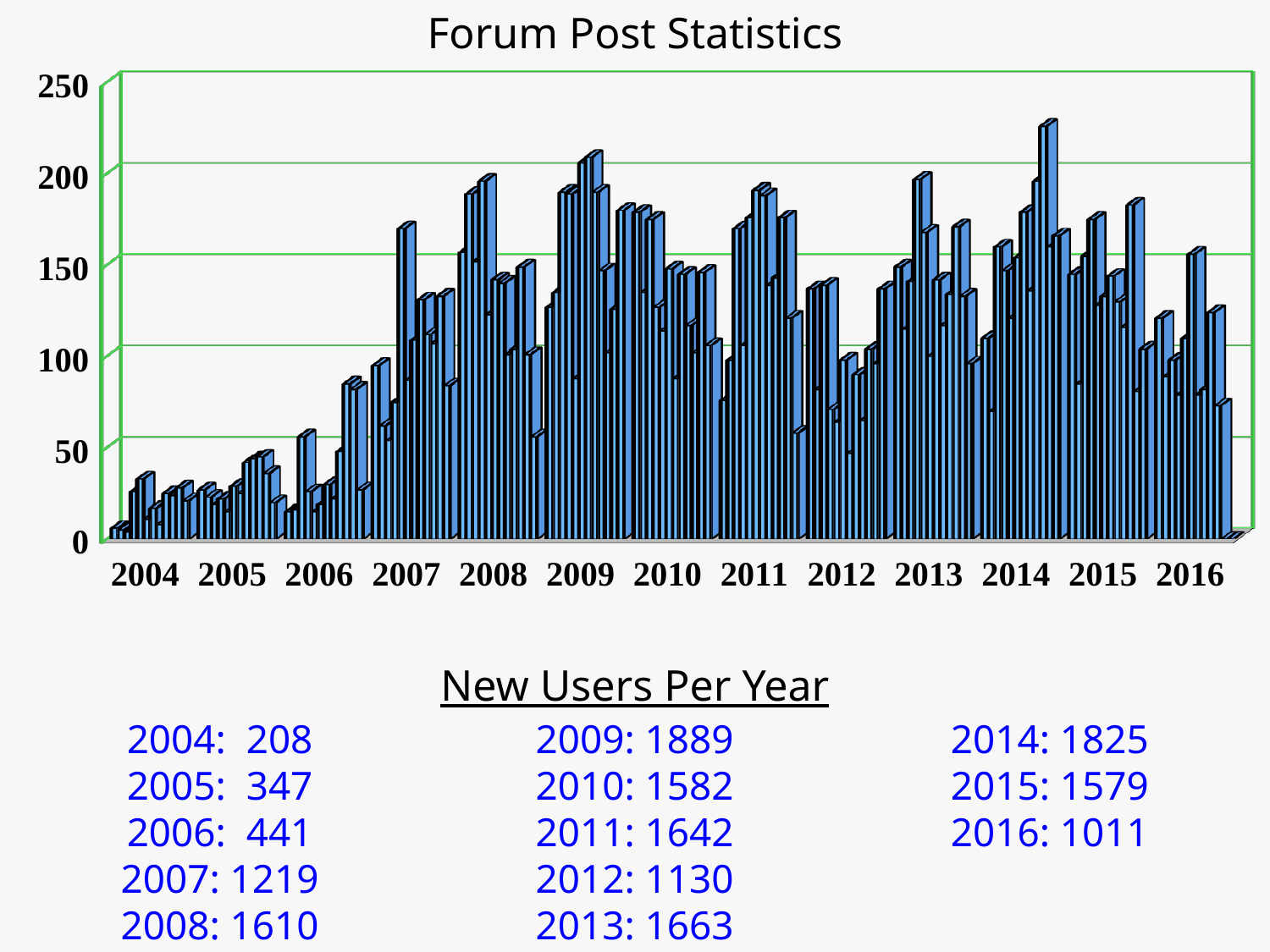
What kind of chart is shown on the slide? bar chart What is the highest tick value shown on the y axis of the chart? 250 Do the bars generally rise or fall from 2004 to 2007? rise How many year labels appear along the x axis of the chart? 13 Is the tallest bar in 2014 greater or less than 200? greater In which year does the tallest bar of the chart appear? 2014 Is the tallest bar in 2016 greater or less than 200? less In which year are the shortest bars of the chart found? 2004 Which year has the taller peak bar, 2008 or 2012? 2008 Is the tallest bar in 2007 greater or less than 150? greater What is the title of the chart? Forum Post Statistics